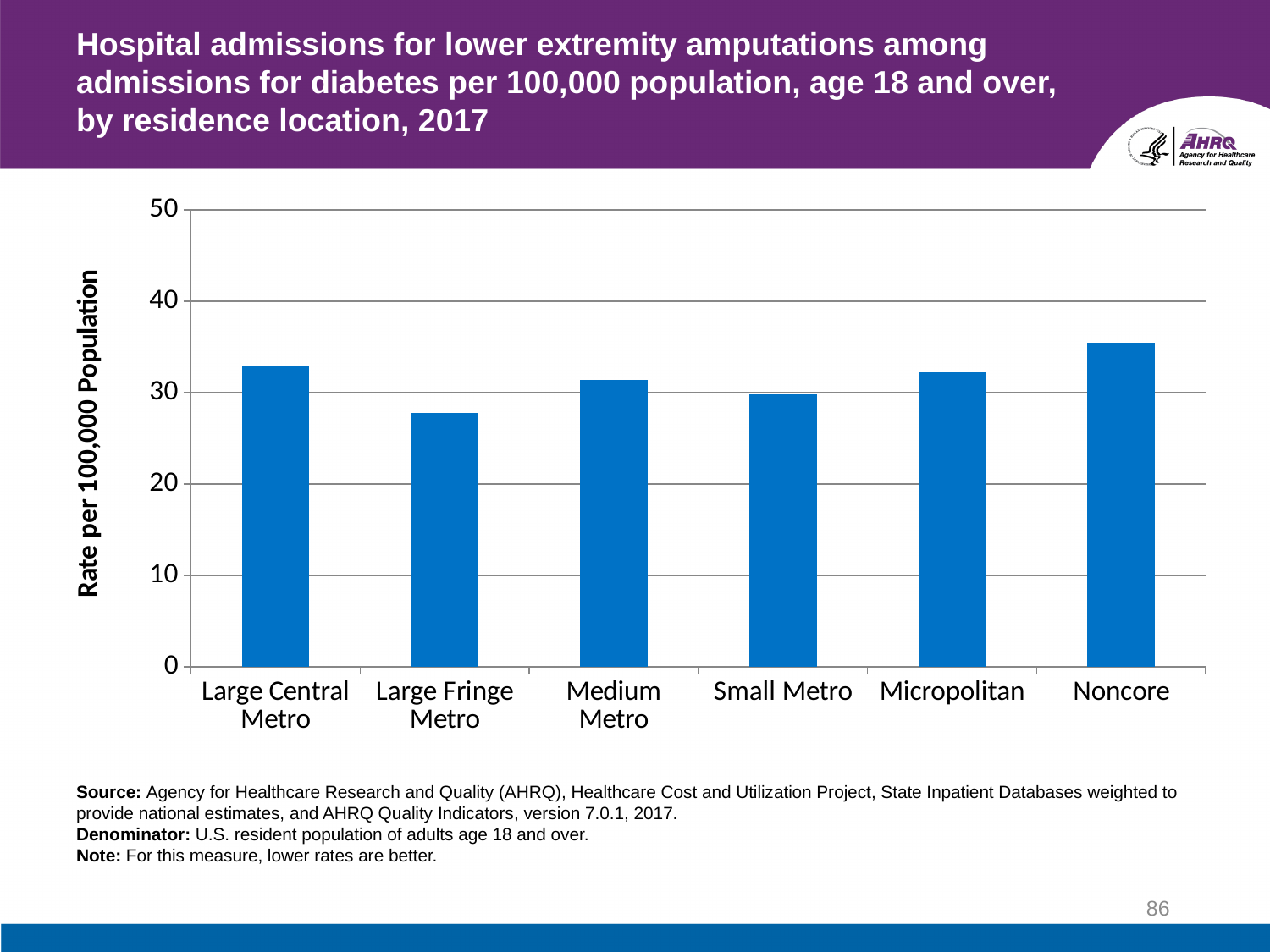
What is the label on the vertical axis of the chart? Rate per 100,000 Population Which residence location has the highest rate of lower extremity amputation admissions? Noncore What year of data does the chart title say it shows? 2017 Is the value for Noncore greater or less than 40? less Which residence location has the lowest rate of lower extremity amputation admissions? Large Fringe Metro Is the value for Large Fringe Metro greater or less than 30? less Is the value for Large Central Metro greater or less than 30? greater How many residence location categories are shown on the x axis? 6 Which has a higher rate, Large Central Metro or Small Metro? Large Central Metro What kind of chart is shown on the slide? bar chart Which has a higher rate, Noncore or Large Fringe Metro? Noncore